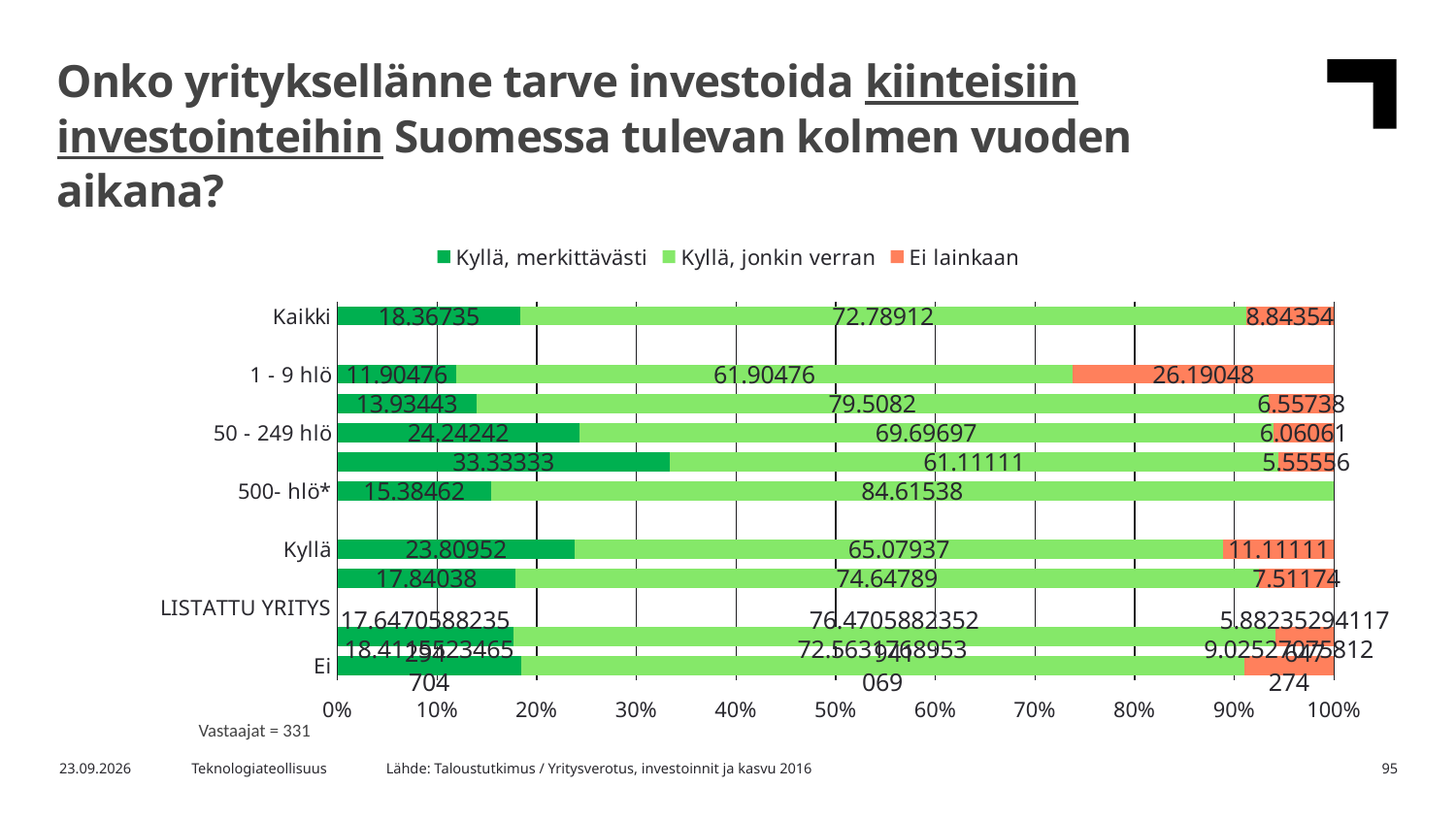
Which has the larger "Ei lainkaan" value, 1 - 9 hlö or Kaikki? 1 - 9 hlö What is the value of "Ei lainkaan" for 1 - 9 hlö? 26.19048 Which colour represents the "Ei lainkaan" series in the chart? Orange Which category has the highest "Kyllä, jonkin verran" value? 500- hlö* What is the value of "Kyllä, jonkin verran" for 500- hlö*? 84.61538 How many series does the chart legend list? 3 What is the value of "Kyllä, merkittävästi" for Kaikki? 18.36735 What is the value of "Ei lainkaan" for Kaikki? 8.84354 What is the value of "Ei lainkaan" for Kyllä? 11.11111 What is the value of "Kyllä, merkittävästi" for 50 - 249 hlö? 24.24242 What kind of chart is shown on the slide? Stacked bar chart What is the difference between "Kyllä, jonkin verran" and "Kyllä, merkittävästi" for Kaikki? 54.42177